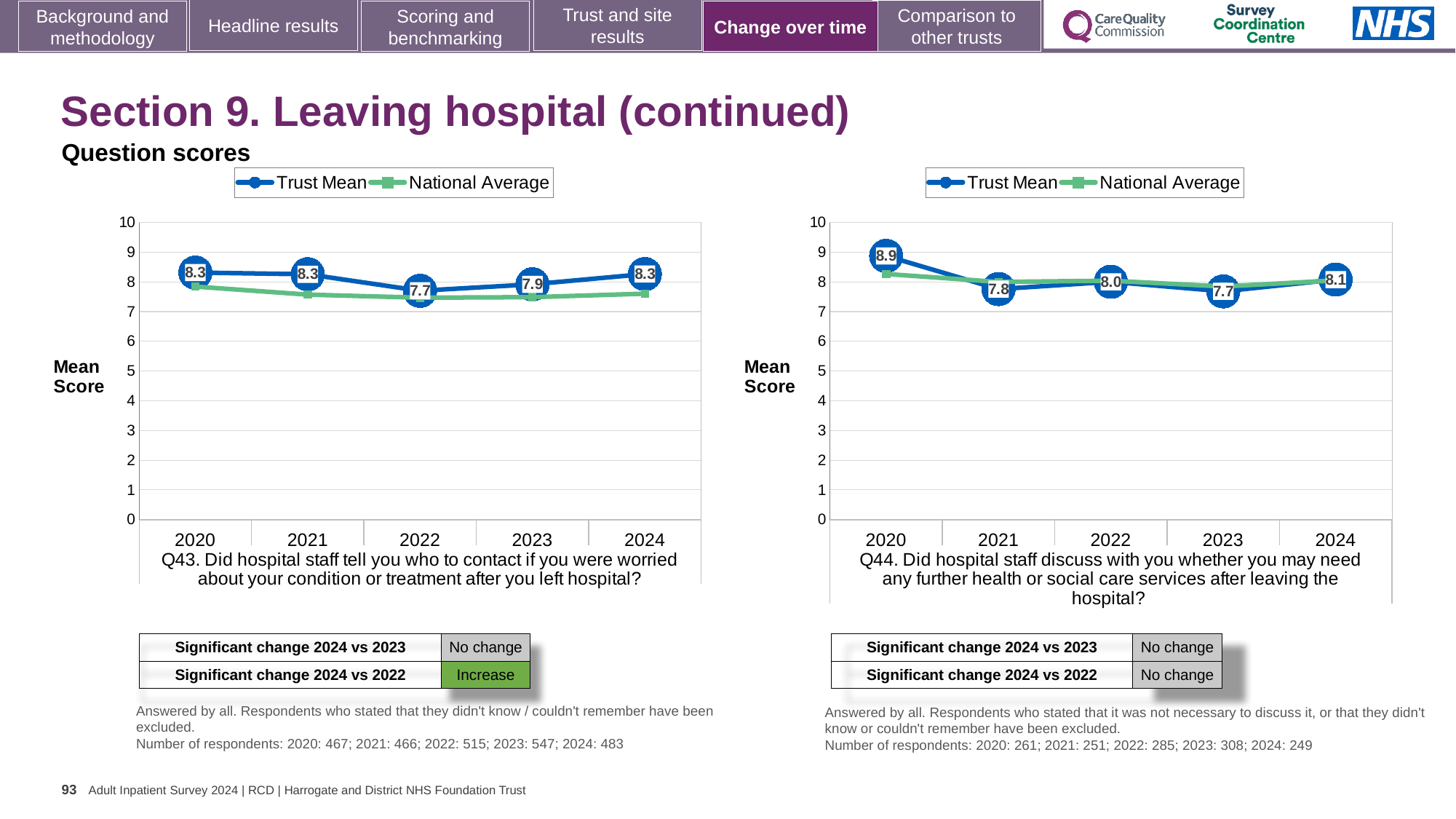
In the Q43 chart on the left, is the National Average for 2020 greater or less than 7? greater In the Q43 chart on the left, what is the difference between the Trust Mean scores for 2024 and 2022? 0.6 In the Q43 chart on the left, which year has the lowest Trust Mean score? 2022 In the Q44 chart on the right, is the Trust Mean score for 2022 higher or lower than for 2023? higher In the Q44 chart on the right, what is the Trust Mean score for 2023? 7.7 In the Q44 chart on the right, which year has the highest Trust Mean score? 2020 In the Q43 chart on the left, what is the Trust Mean score for 2022? 7.7 In the Q44 chart on the right, what is the Trust Mean score for 2020? 8.9 What type of chart is the Q44 chart on the right? line chart In the Q43 chart on the left, what is the Trust Mean score for 2024? 8.3 In the Q44 chart on the right, what is the difference between the Trust Mean scores for 2020 and 2021? 1.1 How many series does the legend of the Q43 chart on the left list? 2